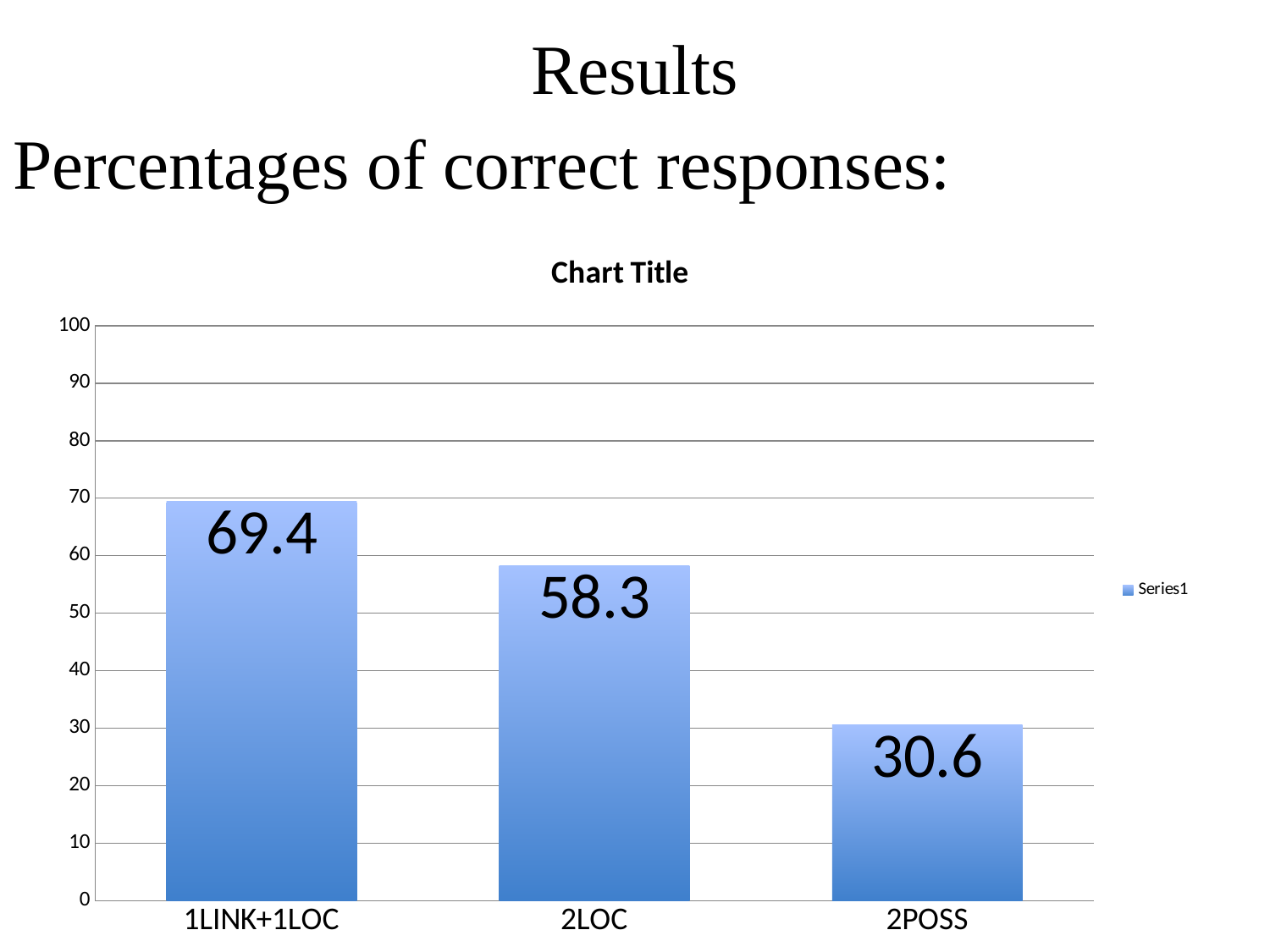
Which is larger, the value for 2LOC or the value for 2POSS? 2LOC What is the difference between the values for 1LINK+1LOC and 2POSS? 38.8 How many categories are shown on the x axis? 3 What is the difference between the values for 1LINK+1LOC and 2LOC? 11.1 Which category has the highest value? 1LINK+1LOC What is the name of the series listed in the legend? Series1 Is the value for 2POSS greater or less than 40? less Which category has the lowest value? 2POSS What kind of chart is shown on the slide? bar chart What is the value for 1LINK+1LOC? 69.4 What is the value for 2LOC? 58.3 What is the value for 2POSS? 30.6